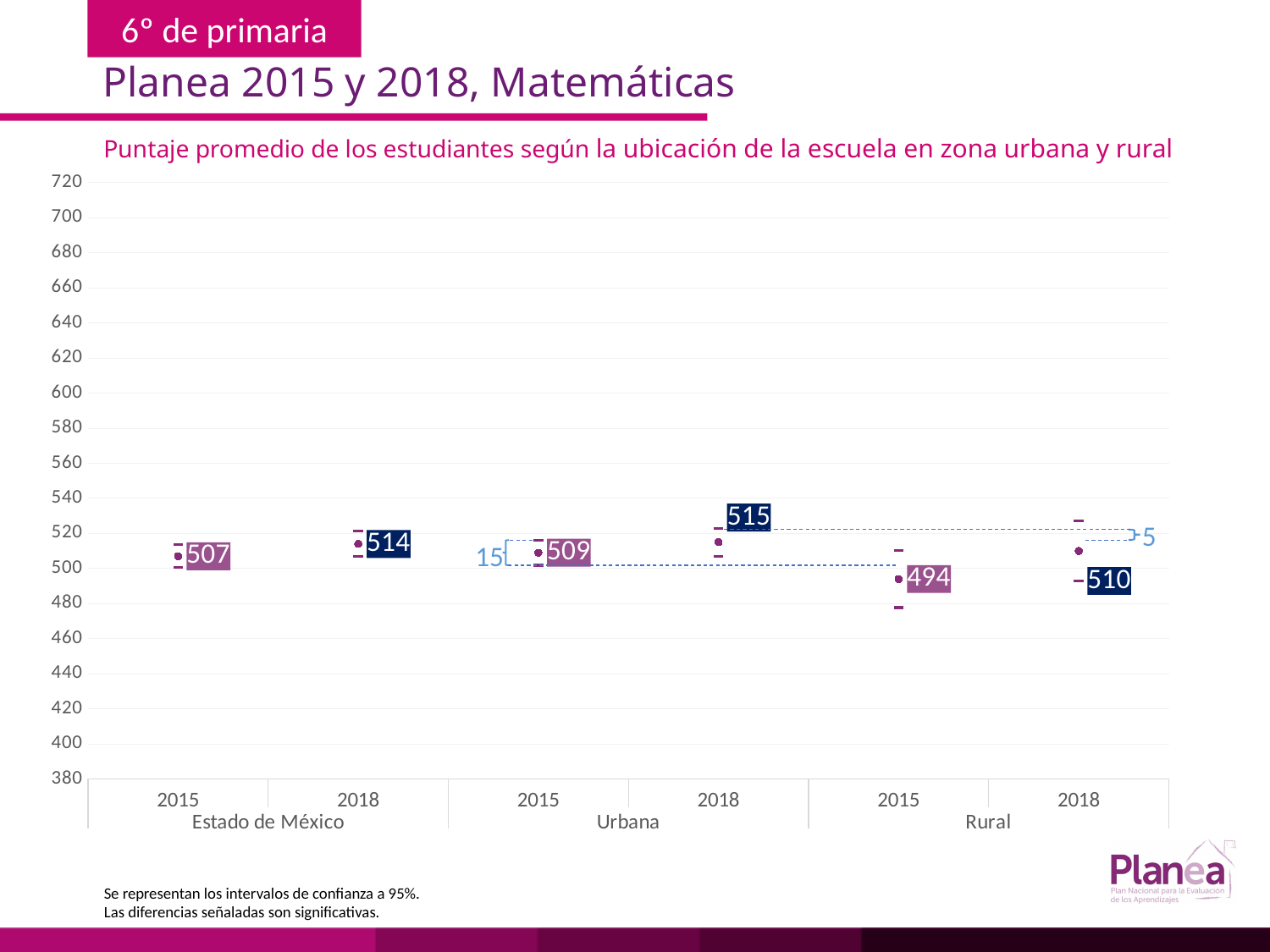
What is the average score for Estado de México in 2018? 514 What is the difference between the Urbana and Rural average scores in 2018? 5 What is the average score for Urbana schools in 2015? 509 What is the average score for Estado de México in 2015? 507 What is the difference between the Urbana and Rural average scores in 2015? 15 Which group and year has the highest average score? Urbana 2018 What is the average score for Rural schools in 2015? 494 Which group and year has the lowest average score? Rural 2015 What is the average score for Urbana schools in 2018? 515 How many data points are plotted on the chart? 6 What is the average score for Rural schools in 2018? 510 Did the Rural average score rise or fall from 2015 to 2018? rise